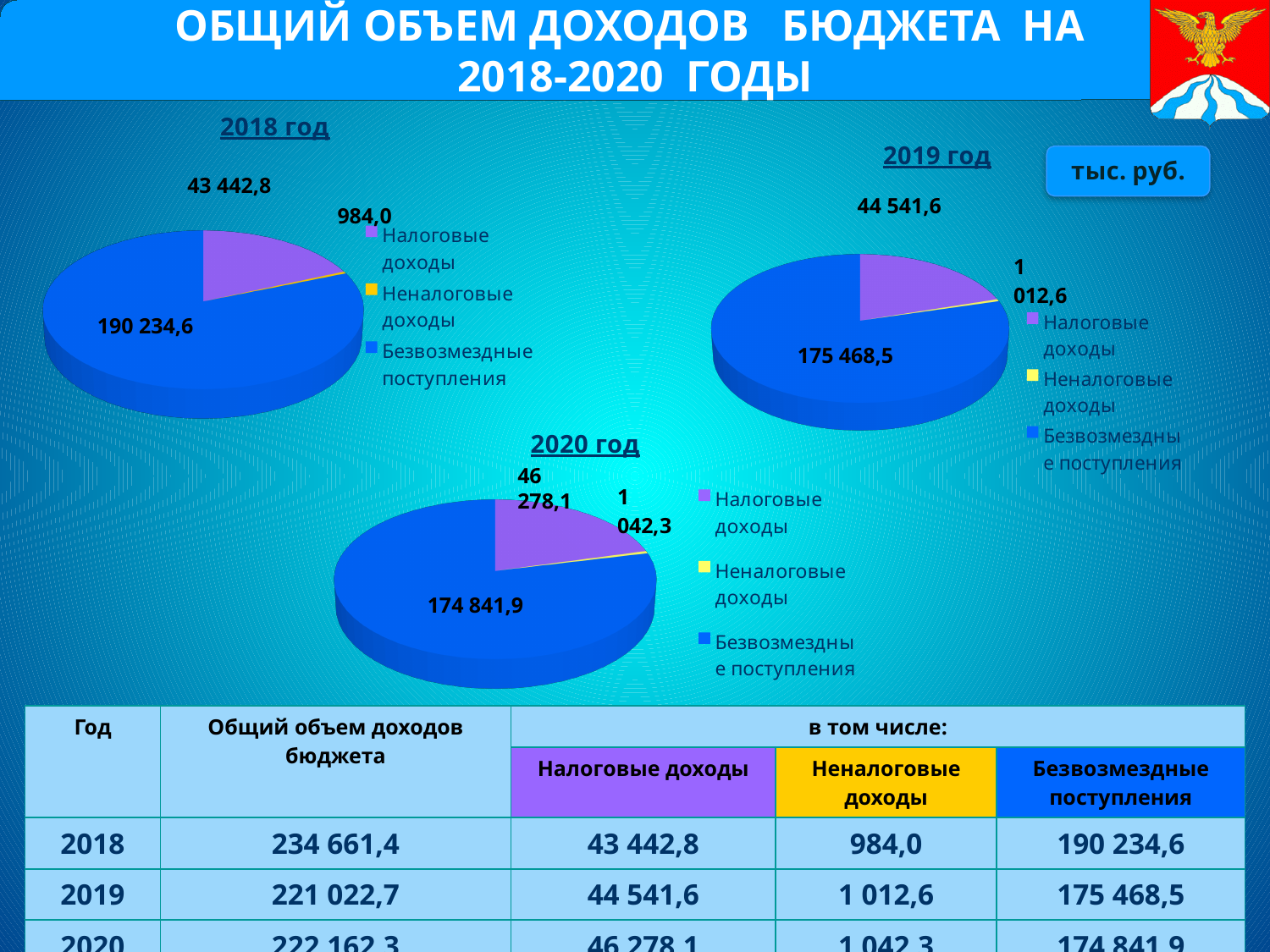
How many slices does the 2020 год pie chart have? 3 On the 2018 год pie chart, what is the difference between Безвозмездные поступления and Налоговые доходы? 146 791,8 On the 2019 год pie chart, what is the value for Налоговые доходы? 44 541,6 What type of chart is used for the 2018 год data? Pie chart On the 2020 год pie chart, what is the value for Неналоговые доходы? 1 042,3 How many entries does the legend of the 2019 год pie chart list? 3 On the 2019 год pie chart, what is the difference between Безвозмездные поступления and Налоговые доходы? 130 926,9 On the 2018 год pie chart, which category has the largest slice? Безвозмездные поступления On the 2018 год pie chart, what is the value for Безвозмездные поступления? 190 234,6 On the 2019 год pie chart, which category has the smallest slice? Неналоговые доходы What is the total of all three slices on the 2020 год pie chart? 222 162,3 On the 2020 год pie chart, which is larger: Налоговые доходы or Неналоговые доходы? Налоговые доходы